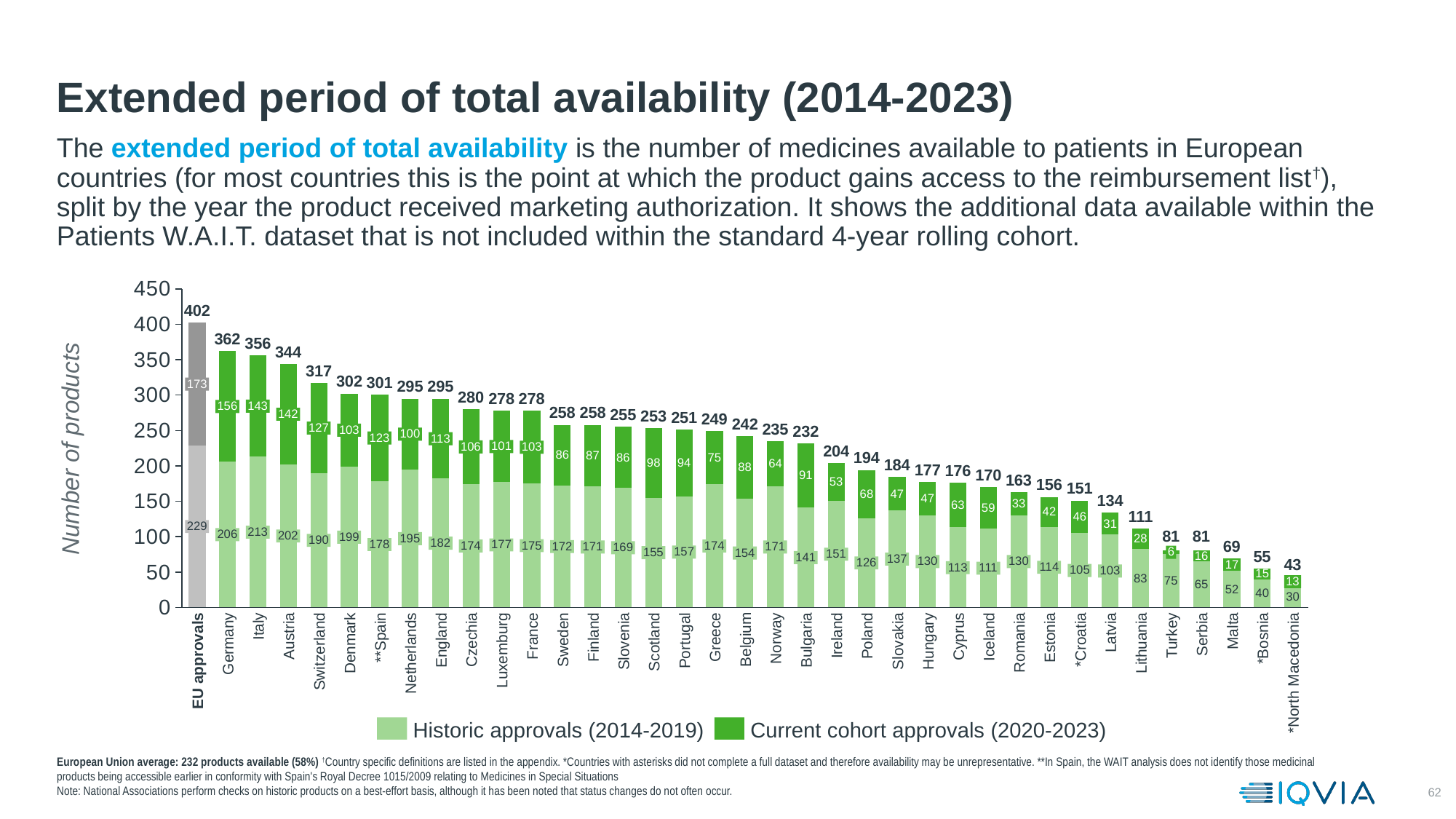
What is the current cohort approvals (2020-2023) value for Switzerland? 127 How many bars (categories) are plotted in the chart? 37 Which has a larger total number of products, Poland or Slovakia? Poland What is the label of the y axis? Number of products What type of chart is shown on the slide? Stacked bar chart What is the total number of products shown for Germany? 362 Which country (excluding EU approvals) has the lowest total number of products? *North Macedonia How many series does the legend list? 2 What is the historic approvals (2014-2019) value for Italy? 213 Do the total values rise or fall moving from left to right along the x axis? Fall Which bar has the highest total in the chart? EU approvals What is the difference between the total for Germany and the total for Italy? 6